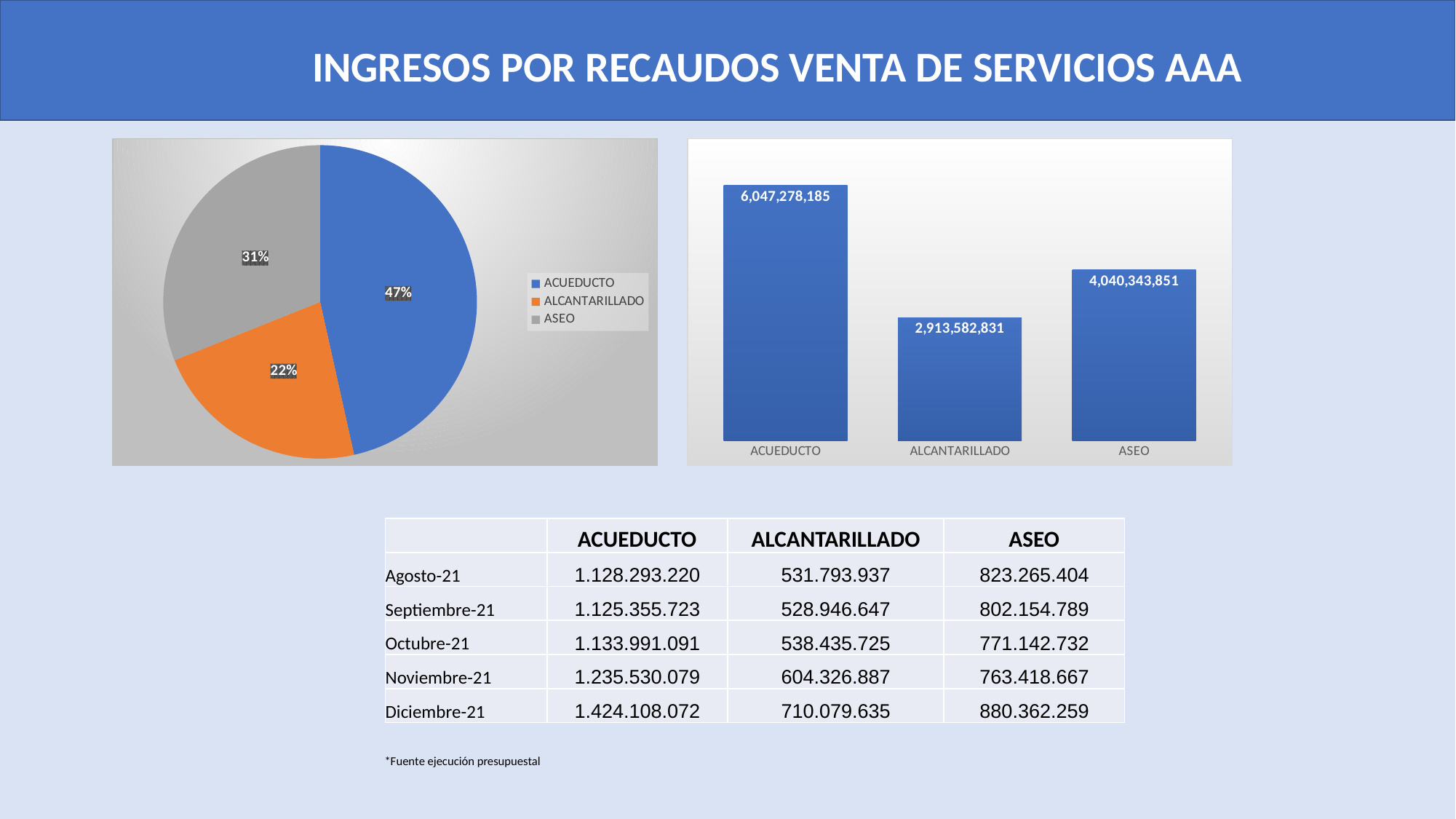
In the bar chart on the right, what is the difference between the values for ACUEDUCTO and ALCANTARILLADO? 3,133,695,354 In the bar chart on the right, which category has the highest value? ACUEDUCTO In the bar chart on the right, which category has the lowest value? ALCANTARILLADO In the bar chart on the right, what is the value for ASEO? 4,040,343,851 In the pie chart on the left, what share does ALCANTARILLADO have? 22% In the bar chart on the right, what is the difference between the values for ASEO and ALCANTARILLADO? 1,126,761,020 In the pie chart on the left, which slice is the smallest? ALCANTARILLADO In the bar chart on the right, what is the value for ALCANTARILLADO? 2,913,582,831 In the pie chart on the left, what share does ACUEDUCTO have? 47% How many bars are in the bar chart on the right? 3 In the bar chart on the right, what is the value for ACUEDUCTO? 6,047,278,185 In the bar chart on the right, which is larger, the value for ASEO or the value for ALCANTARILLADO? ASEO